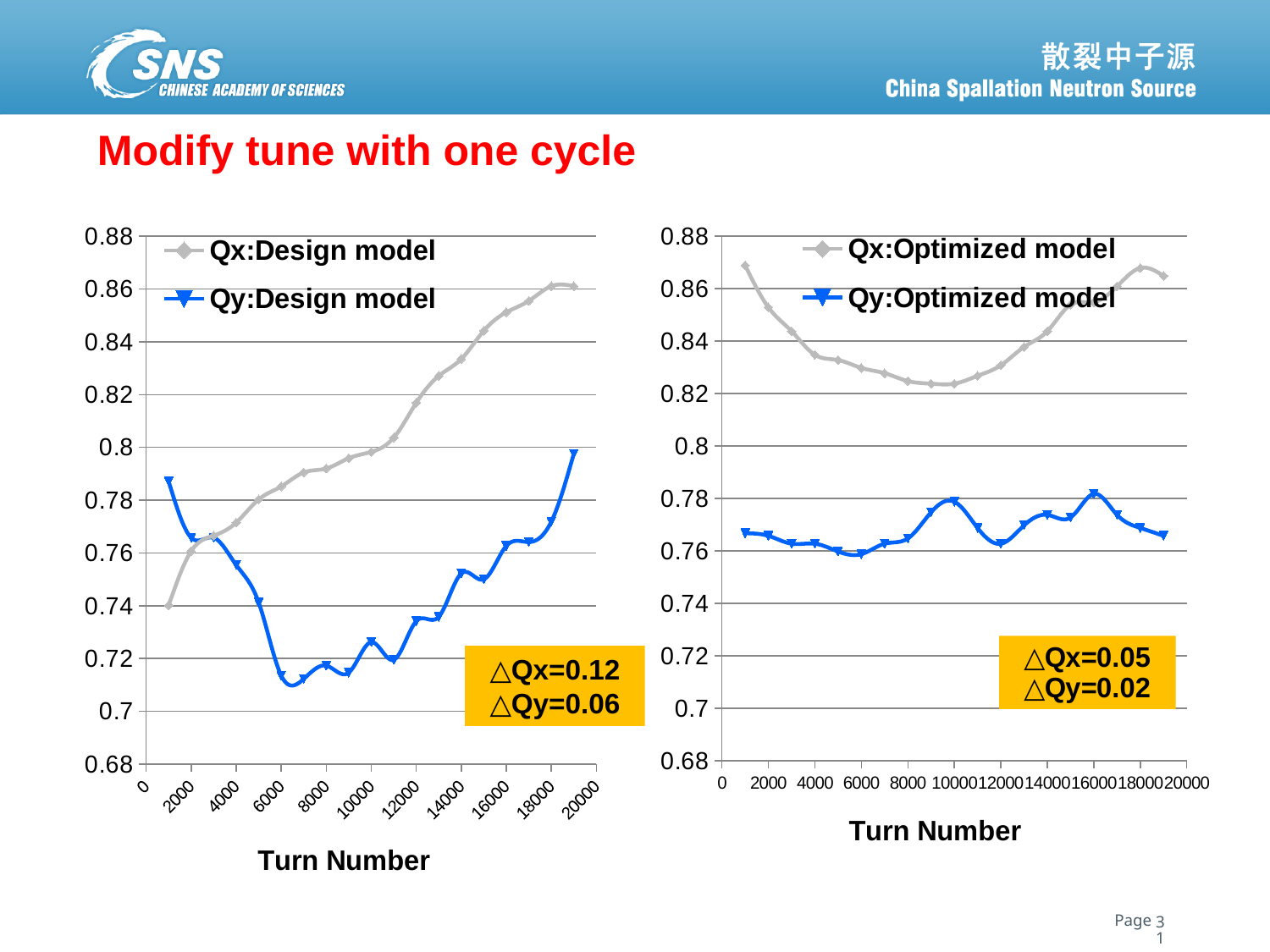
In the left chart, does Qx:Design model generally rise or fall as the turn number increases? rise In the right chart, which series has the larger value at turn 6000, Qx:Optimized model or Qy:Optimized model? Qx:Optimized model In the right chart, does Qx:Optimized model rise or fall between turn 0 and turn 10000? fall What is the x-axis title of the right chart? Turn Number In the right chart, is the value of Qy:Optimized model at turn 10000 greater or less than 0.76? greater How many series does the legend of the right chart list? 2 In the left chart, is the value of Qx:Design model at turn 18000 greater or less than 0.84? greater In the left chart, which series has the larger value at turn 18000, Qx:Design model or Qy:Design model? Qx:Design model What kind of chart is the left chart? line chart What are the two series named in the legend of the left chart? Qx:Design model and Qy:Design model In the left chart, is the value of Qy:Design model at turn 6000 greater or less than 0.74? less